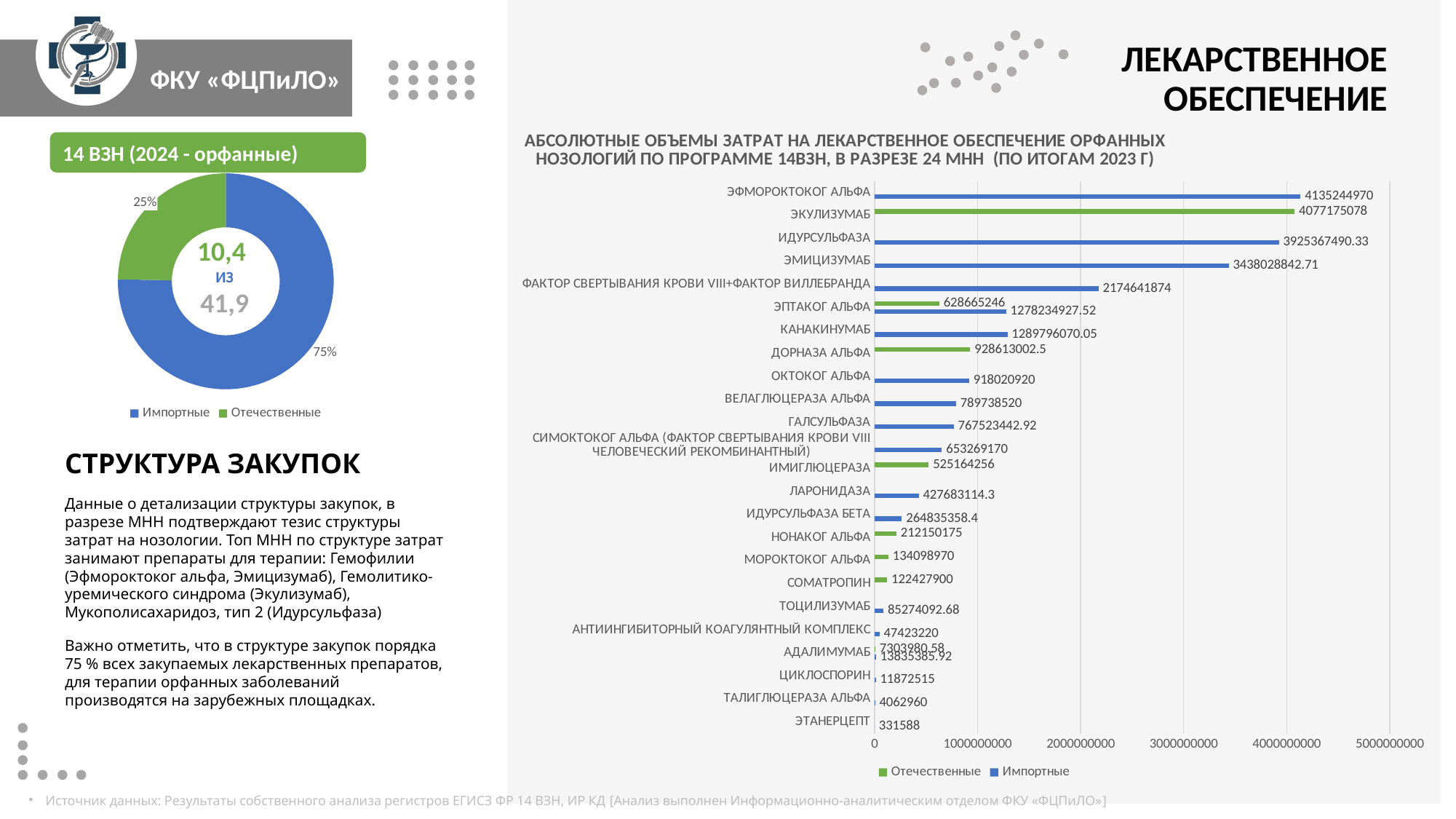
On the donut chart titled «14 ВЗН (2024 - орфанные)», what share is labelled for Отечественные? 25% On the bar chart on the right, what is the Импортные value for ЭПТАКОГ АЛЬФА? 1278234927.52 On the bar chart on the right, what is the value for ДОРНАЗА АЛЬФА? 928613002.5 On the bar chart on the right, which category has the highest value? ЭФМОРОКТОКОГ АЛЬФА On the bar chart on the right, which is larger: the value for КАНАКИНУМАБ or the value for ОКТОКОГ АЛЬФА? КАНАКИНУМАБ On the bar chart on the right, what is the difference between the values for ЭФМОРОКТОКОГ АЛЬФА and ЭКУЛИЗУМАБ? 58069892 On the bar chart on the right, what is the value for ЭКУЛИЗУМАБ? 4077175078 On the donut chart on the left, what value is shown in the centre of the ring? 10,4 из 41,9 On the bar chart on the right, which category has the lowest value? ЭТАНЕРЦЕПТ How many categories (МНН) are listed on the bar chart on the right? 24 On the donut chart titled «14 ВЗН (2024 - орфанные)», what share is labelled for Импортные? 75% What type of chart is the chart on the right side of the slide? Bar chart